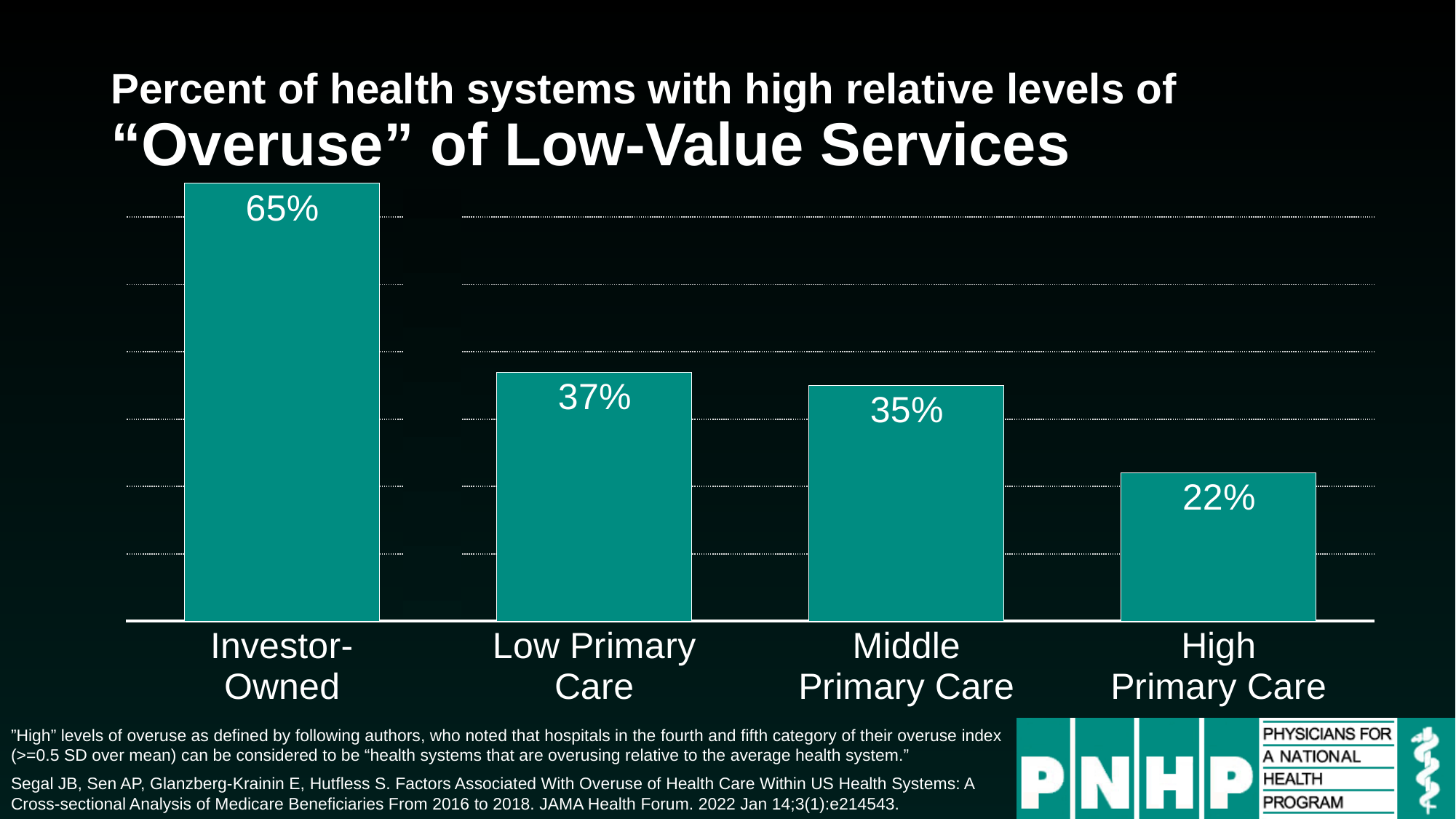
Which category has the lowest value? High Primary Care What is the value for Middle Primary Care? 35% Do the values rise or fall from left to right across the categories? Fall What is the value for Low Primary Care? 37% Which is larger, the value for Investor-Owned or the value for Low Primary Care? Investor-Owned What is the value for Investor-Owned? 65% Which category has the highest value? Investor-Owned How many categories are shown in the chart? 4 What is the difference between the values for Low Primary Care and Middle Primary Care? 2% What is the difference between the values for Investor-Owned and High Primary Care? 43% What kind of chart is shown on the slide? Bar chart What is the value for High Primary Care? 22%